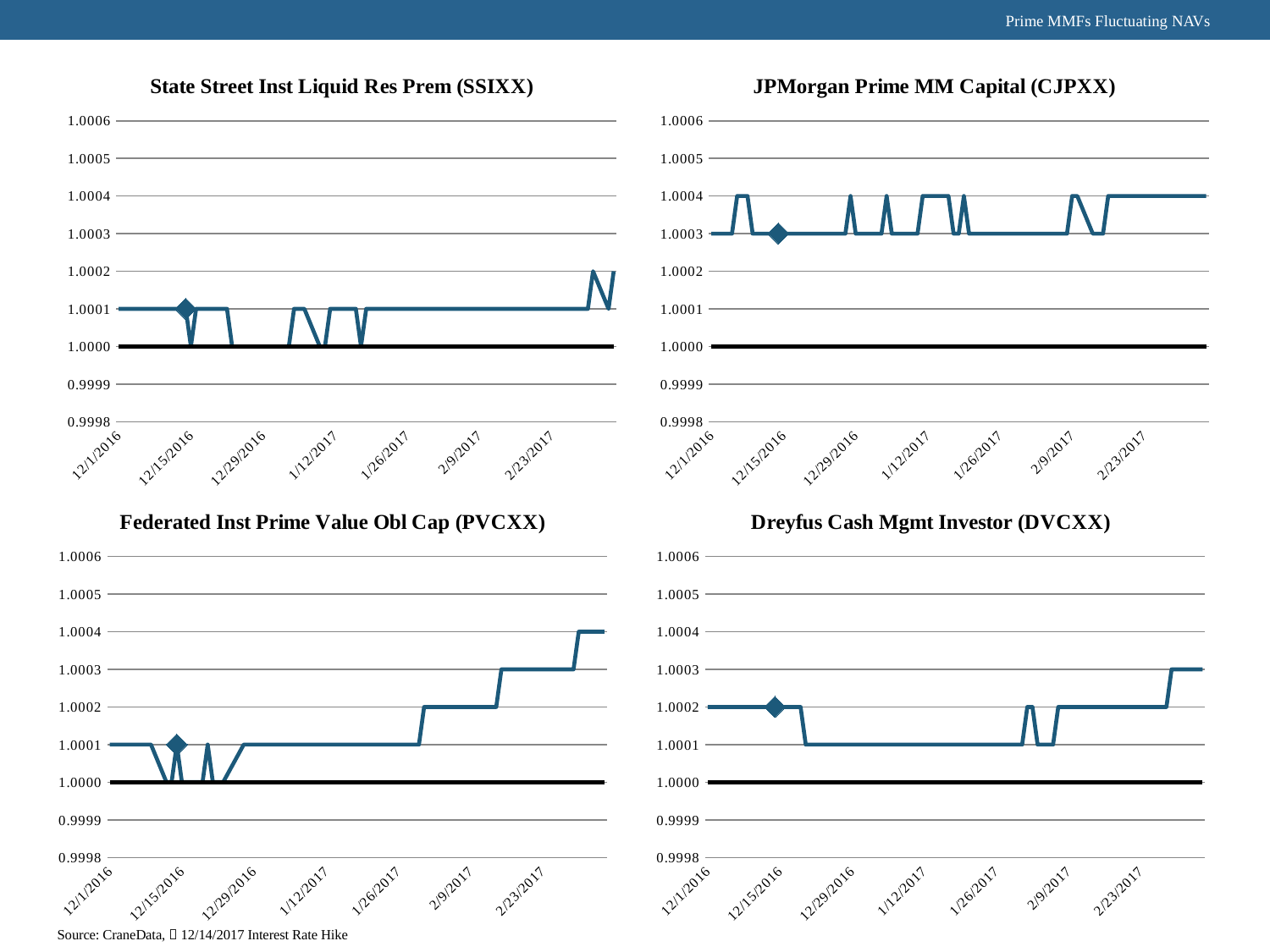
In the Dreyfus Cash Mgmt Investor (DVCXX) chart, what is the highest NAV value reached? 1.0003 In the Federated Inst Prime Value Obl Cap (PVCXX) chart, what is the NAV value at the end of the series, around 2/23/2017? 1.0004 In the JPMorgan Prime MM Capital (CJPXX) chart, are the plotted values greater or less than 1.0002? greater In the State Street Inst Liquid Res Prem (SSIXX) chart, what is the lowest NAV value reached? 1.0000 What kind of chart is the State Street Inst Liquid Res Prem (SSIXX) chart? line chart In the Dreyfus Cash Mgmt Investor (DVCXX) chart, is the NAV value larger at the start (12/1/2016) or at the end (2/23/2017) of the series? at the end (2/23/2017) What is the title of the top-right chart on the slide? JPMorgan Prime MM Capital (CJPXX) How many charts are shown on the slide? 4 In the JPMorgan Prime MM Capital (CJPXX) chart, what is the NAV value at the end of the series, around 2/23/2017? 1.0004 In the Federated Inst Prime Value Obl Cap (PVCXX) chart, do the values generally rise or fall from 12/1/2016 to 2/23/2017? rise In the Dreyfus Cash Mgmt Investor (DVCXX) chart, what is the NAV value on 12/1/2016? 1.0002 In the State Street Inst Liquid Res Prem (SSIXX) chart, what is the NAV value on 12/1/2016? 1.0001